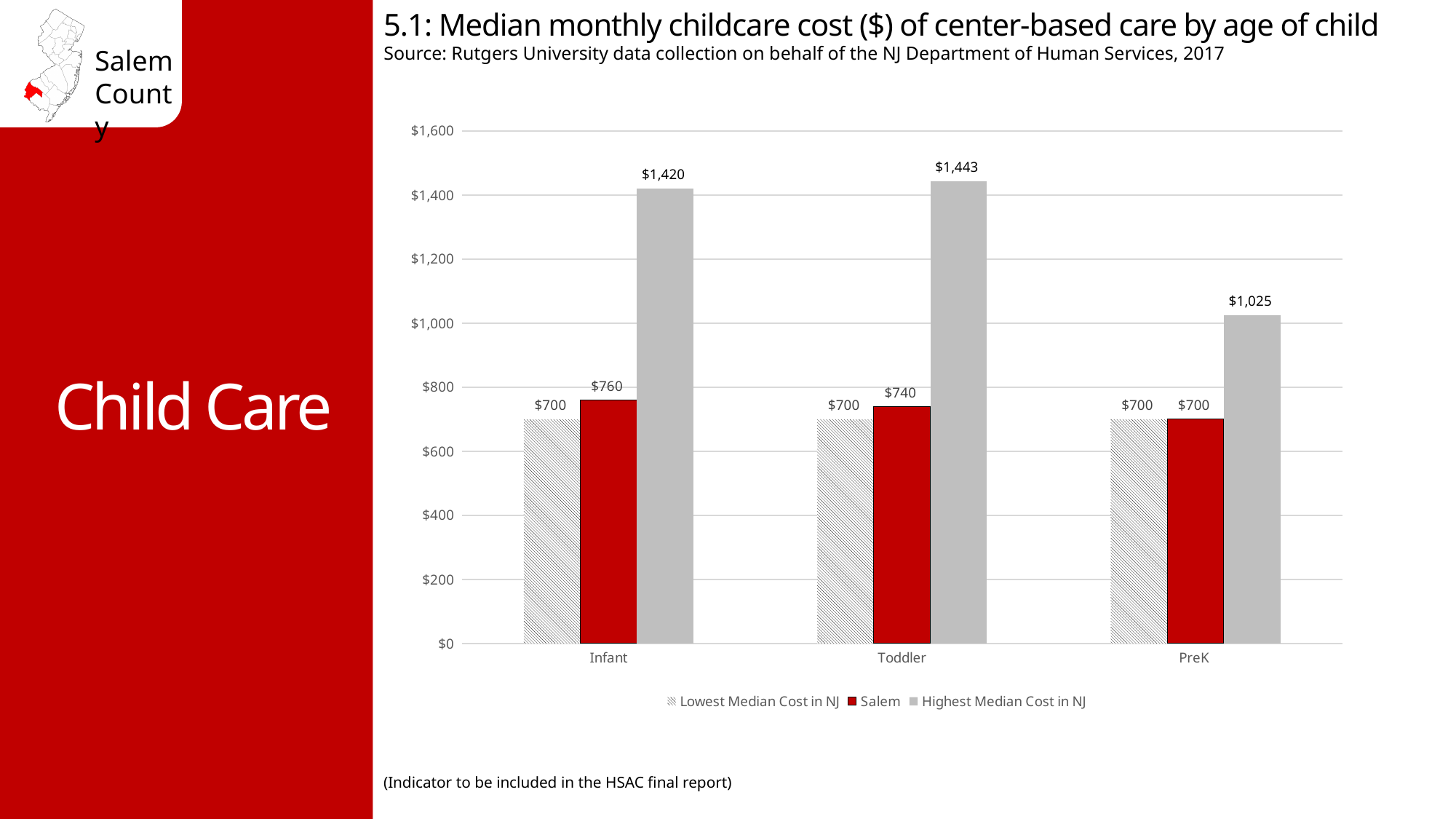
What is the Highest Median Cost in NJ for Toddler care? $1,443 What is the difference between the Highest Median Cost in NJ and the Salem cost for Infant care? $660 How many age groups are shown on the x axis? 3 Which is larger: the Salem cost for Infant care or the Salem cost for Toddler care? Infant What is the difference between the Salem cost for Toddler care and the Lowest Median Cost in NJ for Toddler care? $40 What kind of chart is shown on the slide? Bar chart How many series does the legend list? 3 Is the Highest Median Cost in NJ for PreK care greater or less than $1,200? less Which age group has the highest value for the Highest Median Cost in NJ series? Toddler What is the Lowest Median Cost in NJ for PreK care? $700 Which age group has the lowest Salem median monthly cost? PreK What is the Salem median monthly childcare cost for Infant care? $760